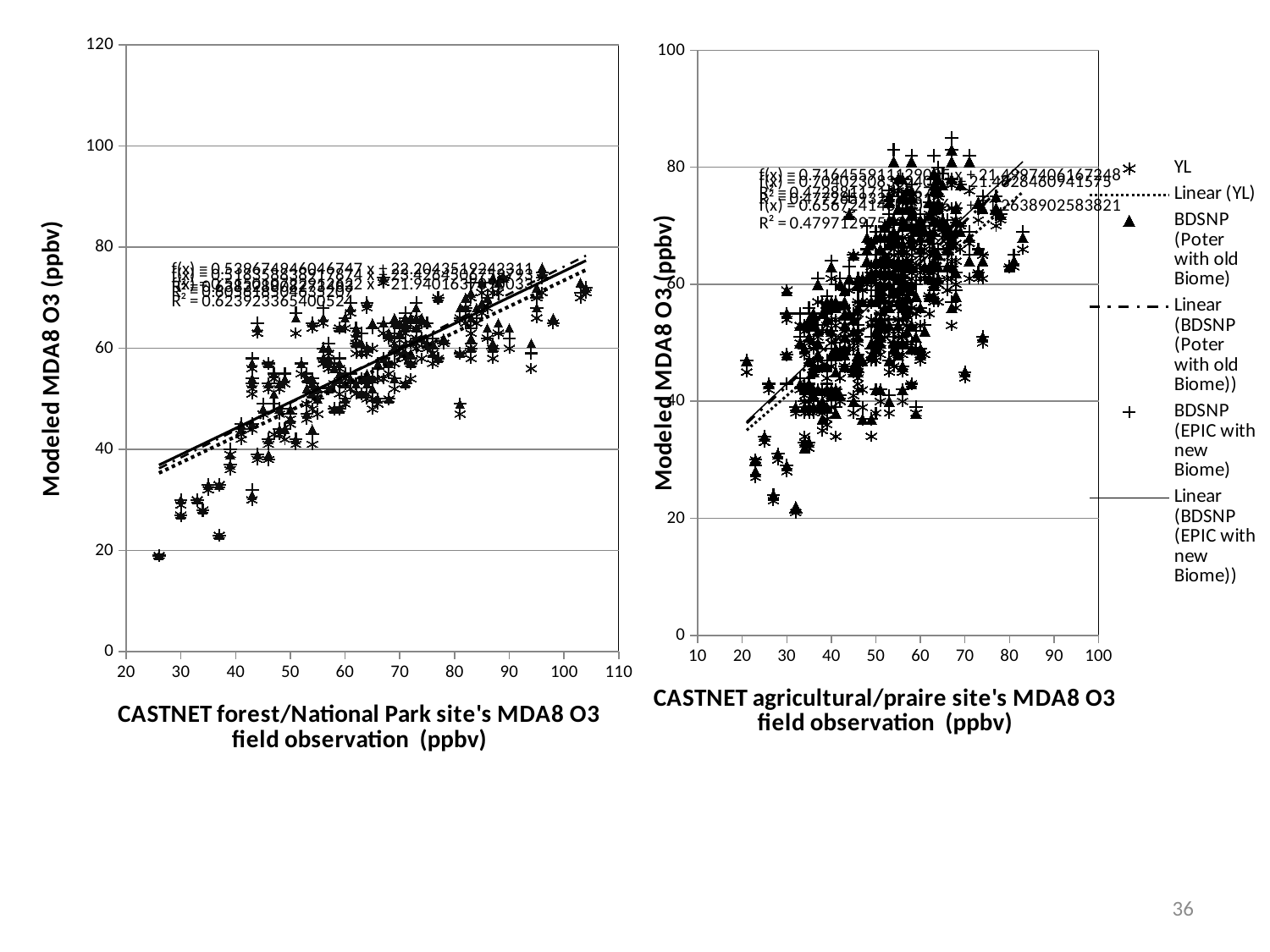
In the right chart (agricultural/praire sites), do the modeled MDA8 O3 values generally rise or fall as the field observation increases along the x axis? rise How many scatter (point) series are plotted in the right chart (agricultural/praire sites), excluding the linear trend lines? 3 What is the lowest value shown on the x axis of the right chart (agricultural/praire sites)? 10 What kind of chart is the right chart, titled with the x-axis label 'CASTNET agricultural/praire site's MDA8 O3 field observation (ppbv)'? scatter chart What is the maximum value shown on the y axis of the right chart (agricultural/praire sites)? 100 How many entries does the legend on the right side of the slide list? 6 What kind of chart is the left chart, titled with the x-axis label 'CASTNET forest/National Park site's MDA8 O3 field observation (ppbv)'? scatter chart What is the maximum value shown on the y axis of the left chart (forest/National Park sites)? 120 What is the highest value shown on the x axis of the left chart (forest/National Park sites)? 110 How many linear trend lines are listed in the legend for the right chart (agricultural/praire sites)? 3 What is the y-axis label of the left chart (forest/National Park sites)? Modeled MDA8 O3 (ppbv) In the left chart (forest/National Park sites), do the modeled MDA8 O3 values generally rise or fall as the field observation increases along the x axis? rise